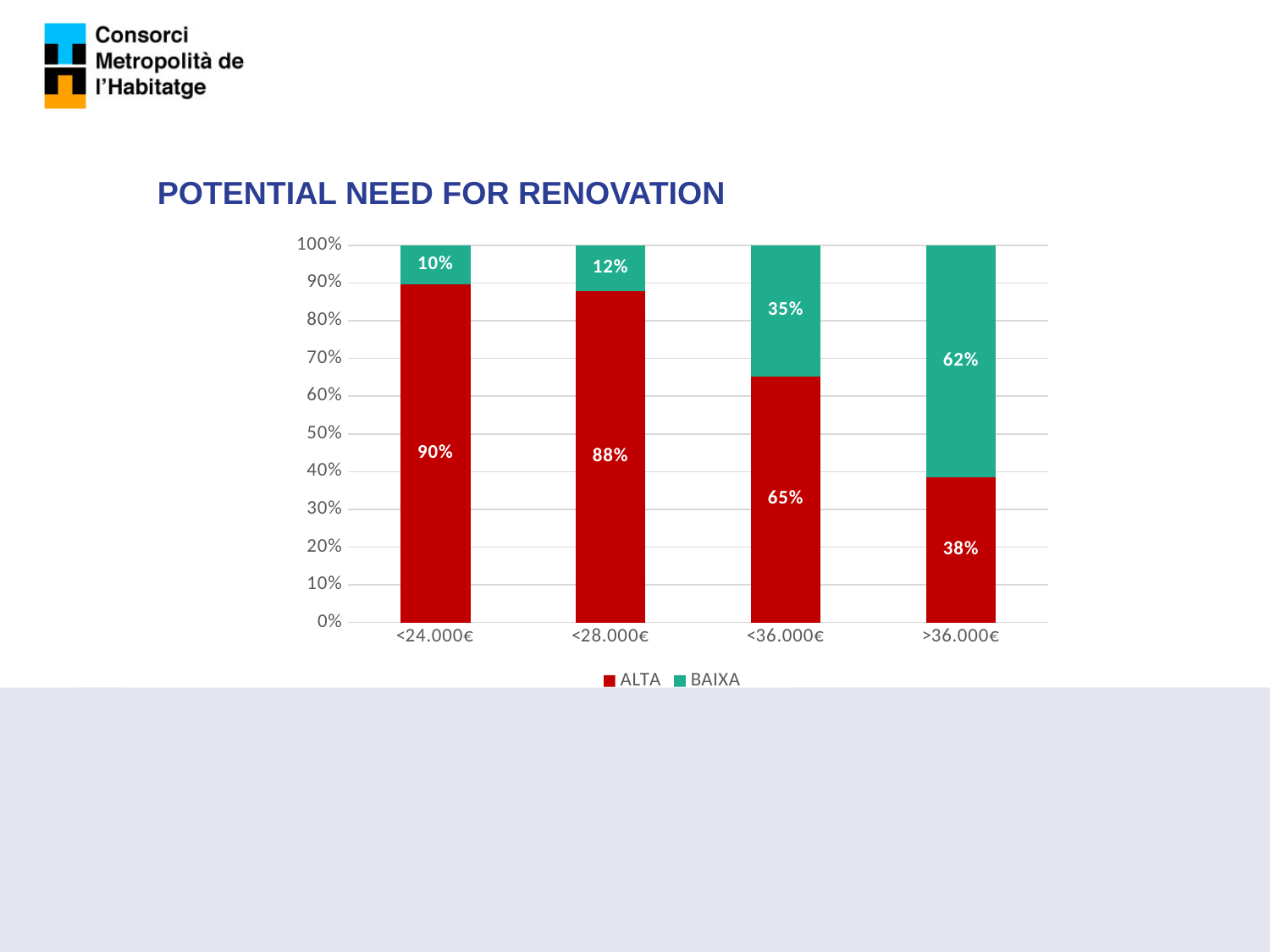
How many series does the legend list? 2 What is the BAIXA value for the >36.000€ category? 62% How many categories are shown on the x axis? 4 Do the ALTA values rise or fall from <24.000€ to >36.000€? Fall What is the difference between the ALTA values for <28.000€ and >36.000€? 50% What is the ALTA value for the <36.000€ category? 65% Which is larger, the BAIXA value for <36.000€ or the BAIXA value for <28.000€? <36.000€ What kind of chart is shown on the slide? Stacked bar chart What is the ALTA value for the <24.000€ category? 90% Which category has the highest ALTA value? <24.000€ Which category has the lowest BAIXA value? <24.000€ What is the title of the chart? POTENTIAL NEED FOR RENOVATION